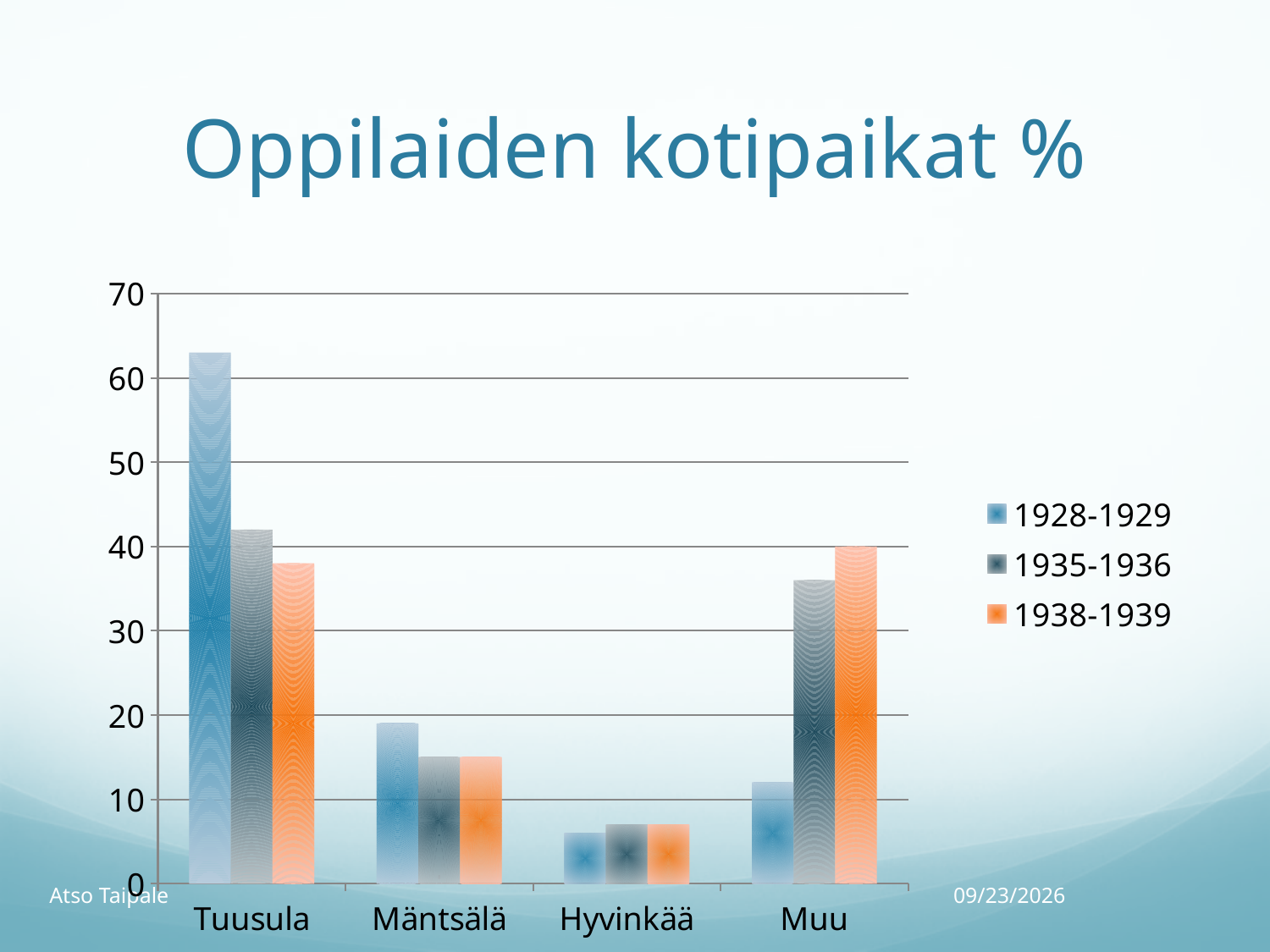
For Muu, which series has the larger value: 1928-1929 or 1935-1936? 1935-1936 Which category has the highest value for the 1928-1929 series? Tuusula How many categories are shown on the x axis? 4 Which category has the highest value for the 1938-1939 series? Muu Is the value for Mäntsälä in 1928-1929 greater or less than 20? less How many series does the legend list? 3 For Tuusula, which series has the larger value: 1935-1936 or 1938-1939? 1935-1936 Is the value for Tuusula in 1928-1929 greater or less than 60? greater Which category has the lowest value for the 1938-1939 series? Hyvinkää Which series is shown in orange in the legend? 1938-1939 What is the title of the chart? Oppilaiden kotipaikat % What kind of chart is shown on the slide? bar chart